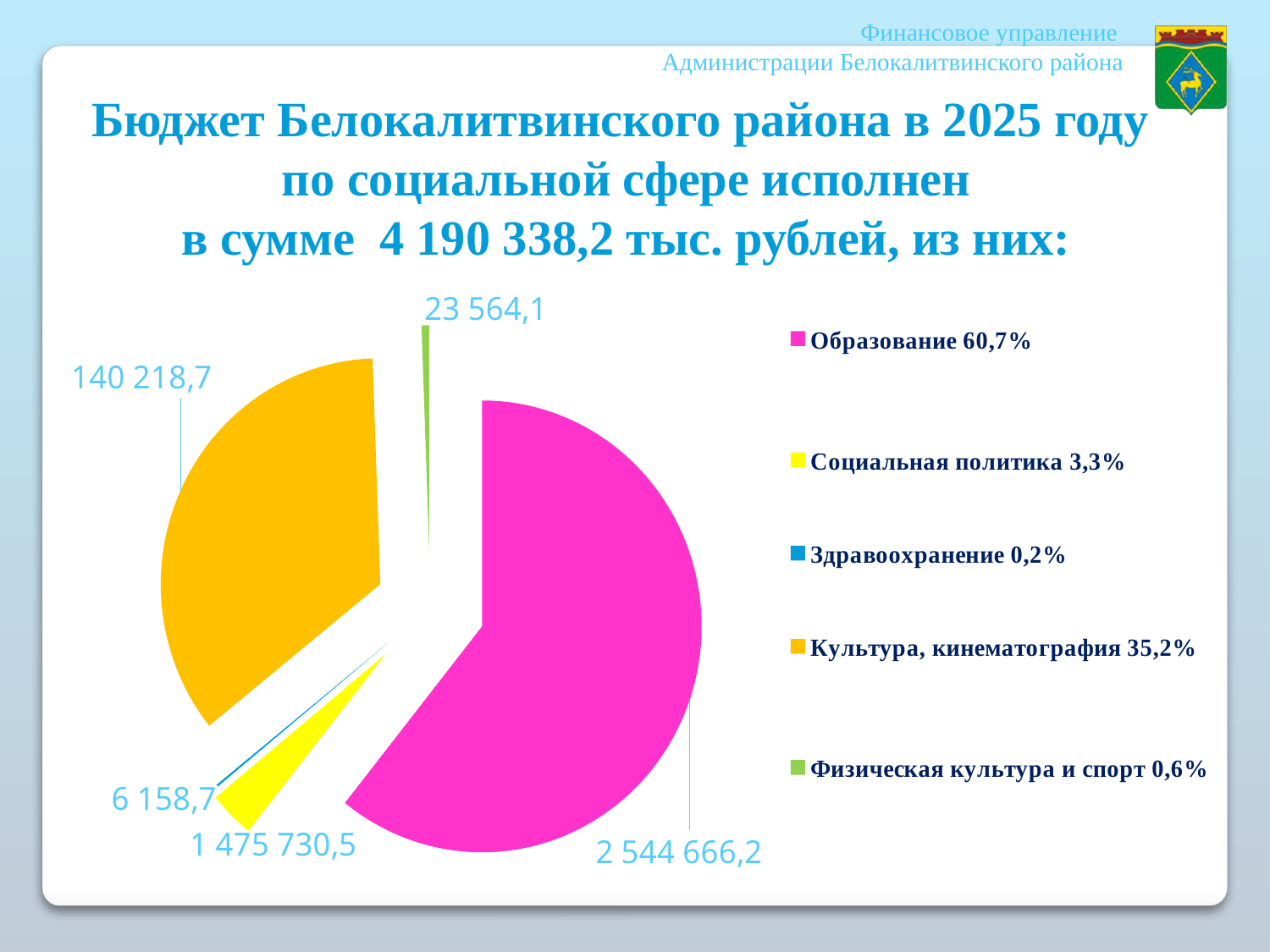
Which category has the smallest slice of the pie? Здравоохранение How many categories does the legend of the pie chart list? 5 What share of the pie does Образование account for? 60,7% Which is larger, the slice for Образование or the slice for Культура, кинематография? Образование What is the data label value for the Здравоохранение slice? 6 158,7 What kind of chart is shown on the slide? Pie chart Which category has the largest slice of the pie? Образование What colour is the Образование slice in the pie chart? Pink (magenta) What share of the pie does Культура, кинематография account for? 35,2% What is the data label value for the Физическая культура и спорт slice? 23 564,1 What is the data label value for the Образование slice? 2 544 666,2 What share of the pie does Социальная политика account for? 3,3%